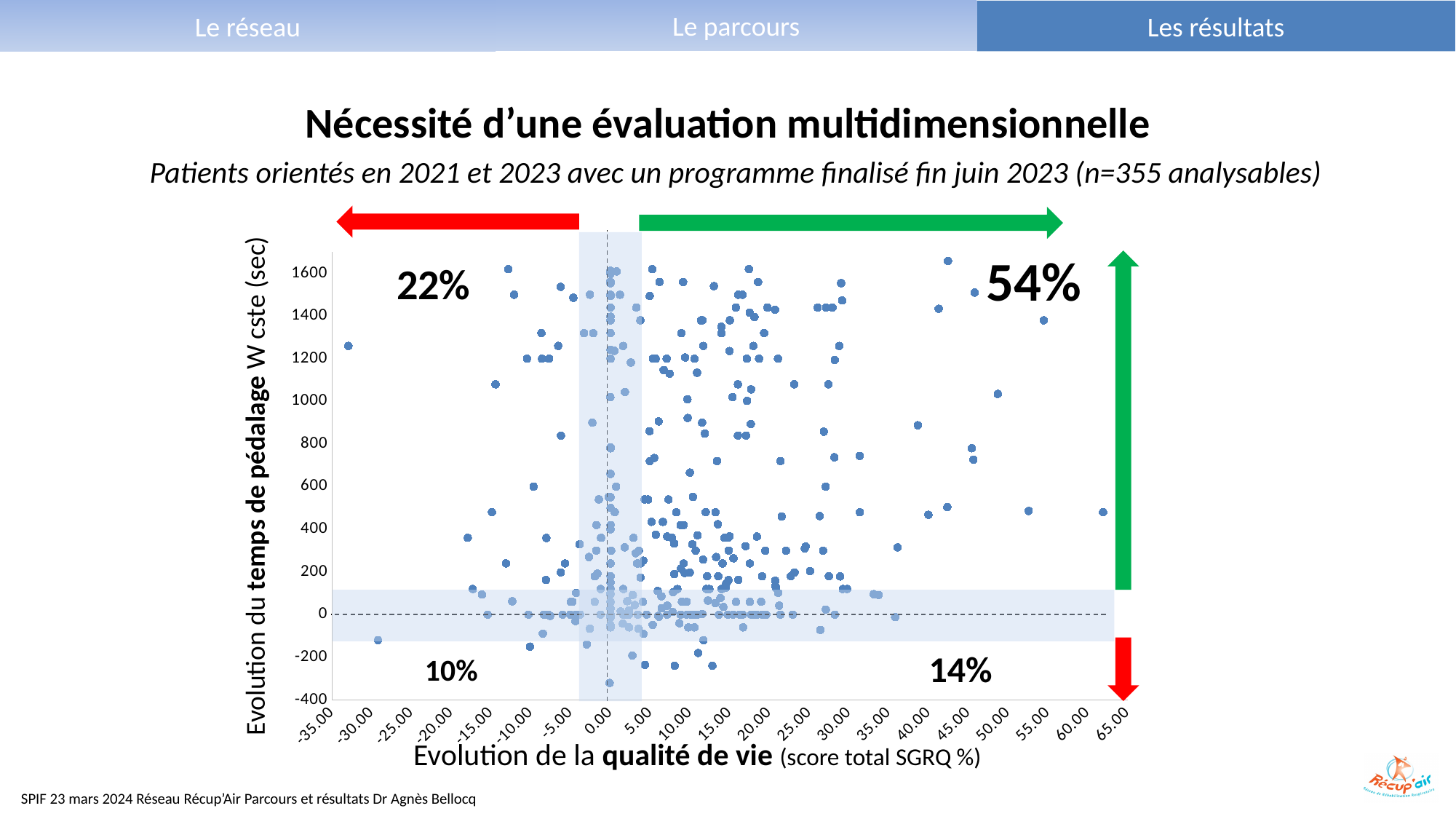
What kind of chart is shown on the slide? Scatter plot What percentage is shown in the bottom-right quadrant of the chart? 14% What percentage is shown in the top-left quadrant of the chart? 22% What is the combined percentage of the two upper quadrants (top-left and top-right)? 76% What percentage is shown in the bottom-left quadrant of the chart? 10% What is the difference between the top-right quadrant percentage and the top-left quadrant percentage? 32 percentage points What is the label of the x axis of the chart? Evolution de la qualité de vie (score total SGRQ %) What percentage is shown in the top-right quadrant of the chart? 54% Is the percentage in the top-left quadrant larger or smaller than the percentage in the bottom-right quadrant? Larger What is the label of the y axis of the chart? Evolution du temps de pédalage W cste (sec) Which quadrant of the chart has the highest percentage of patients? Top-right (54%) Which quadrant of the chart has the lowest percentage of patients? Bottom-left (10%)